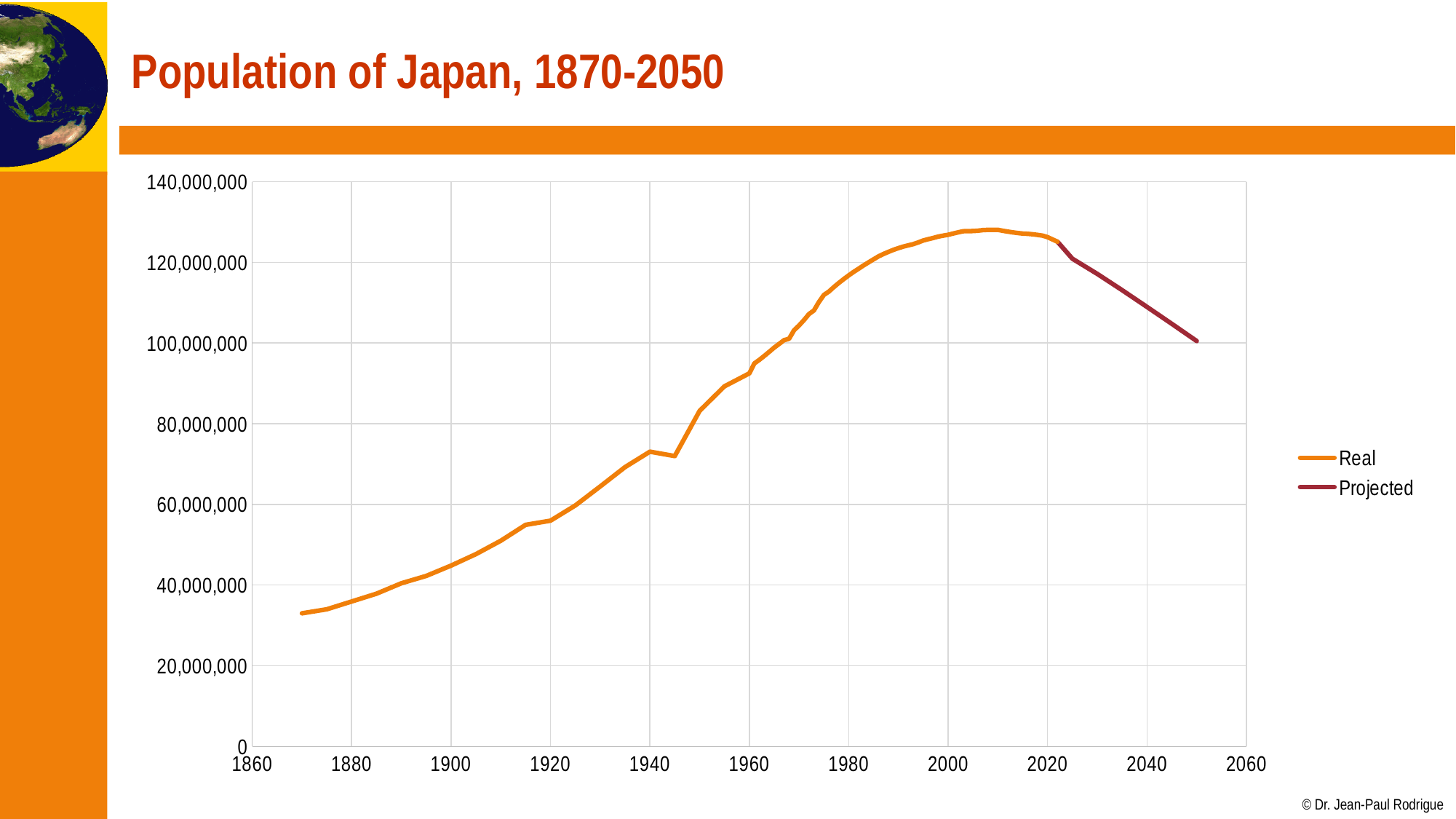
Is the Real population value for 1960 greater or less than 80,000,000? greater How many series does the legend list? 2 Is the Projected population value for 2050 greater or less than 120,000,000? less Which series is drawn in dark red? Projected What is the title of the chart? Population of Japan, 1870-2050 Is the Real population value for 1900 greater or less than 60,000,000? less Which is larger, the Real population in 1920 or in 1960? 1960 What kind of chart is shown on the slide? line chart Does the Projected series rise or fall between 2020 and 2050? fall Does the Real series rise or fall between 1870 and 2000? rise